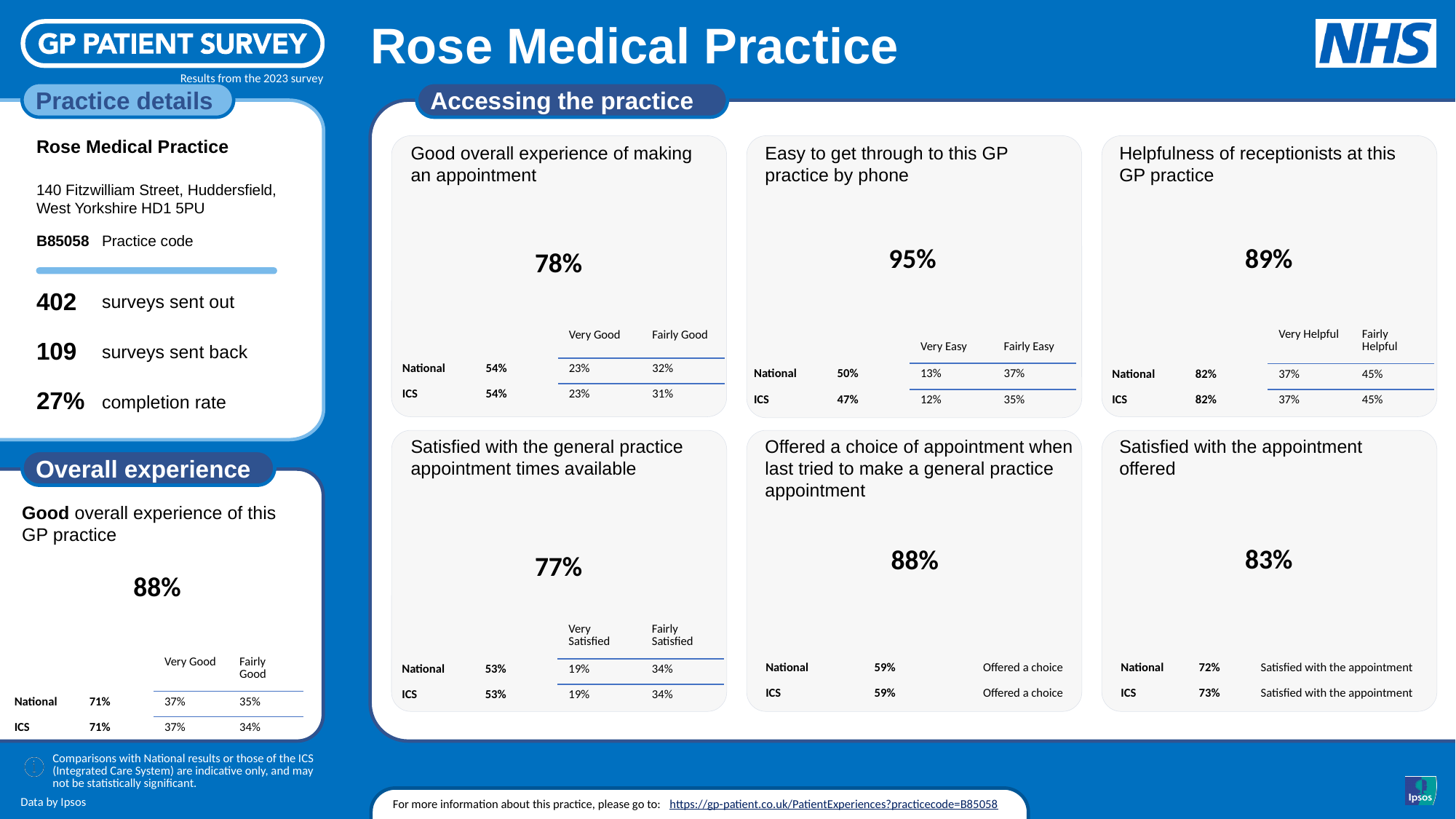
Among the six 'Accessing the practice' panels, which has the highest headline percentage? Easy to get through to this GP practice by phone In the 'Good overall experience of this GP practice' panel, what is the ICS 'Fairly Good' percentage? 34% In the 'Easy to get through to this GP practice by phone' panel, what is the difference between the practice's 95% and the National 50%? 45 percentage points In the 'Good overall experience of this GP practice' panel, is the practice's 88% higher or lower than the National 71%? higher In the 'Helpfulness of receptionists at this GP practice' panel, what is the National percentage? 82% In the 'Offered a choice of appointment when last tried to make a general practice appointment' panel, what is the National percentage? 59% In the 'Easy to get through to this GP practice by phone' panel, what is the practice's headline percentage? 95% How many panels are shown in the 'Accessing the practice' section? 6 What is the completion rate shown in the 'Practice details' section? 27% In the 'Good overall experience of making an appointment' panel, what is the practice's headline percentage? 78% In the 'Satisfied with the appointment offered' panel, what is the ICS percentage? 73% Among the six 'Accessing the practice' panels, which has the lowest headline percentage? Satisfied with the general practice appointment times available